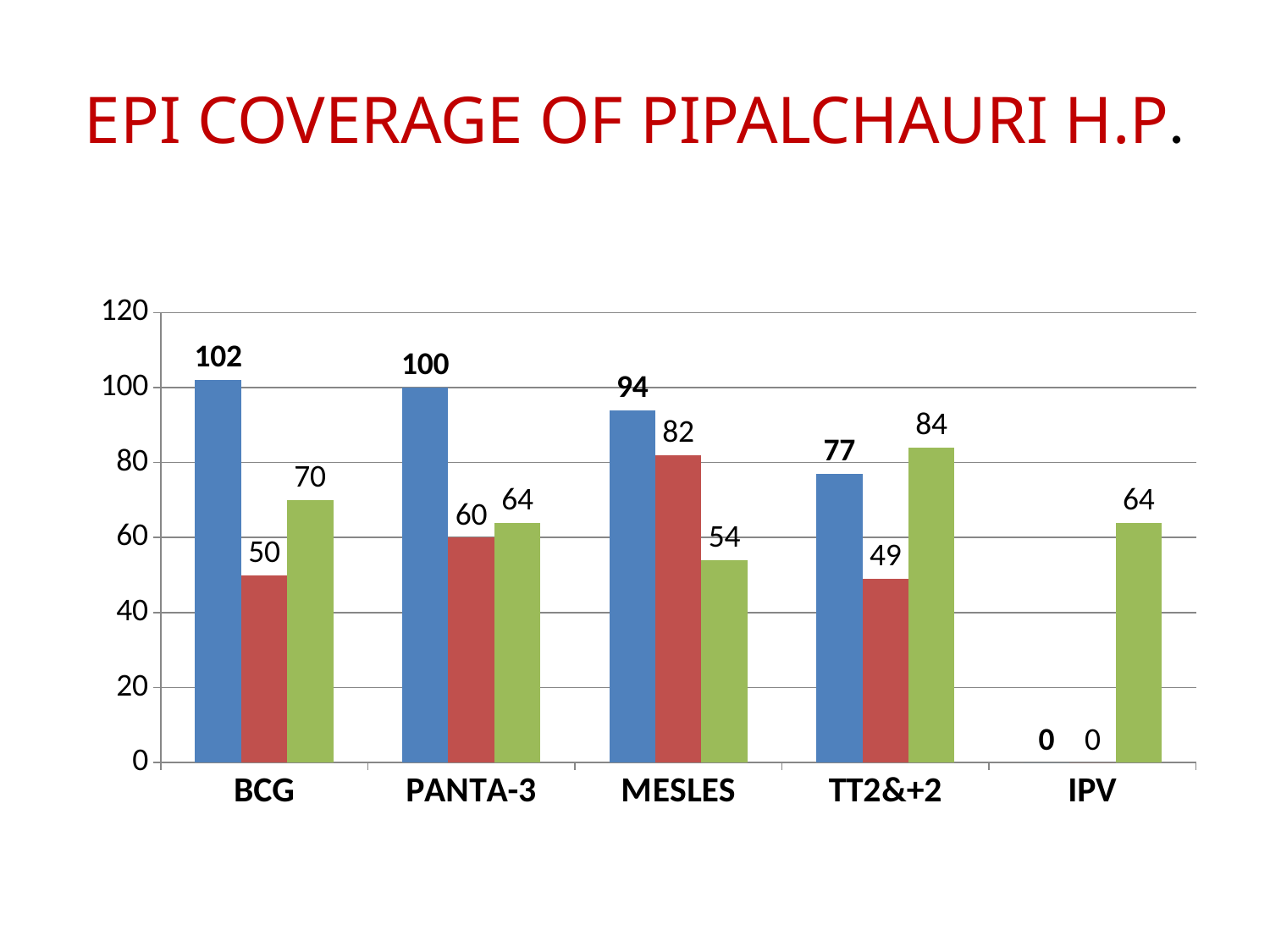
Which category has the lowest red bar? IPV What is the value of the red bar for MESLES? 82 What kind of chart is shown on the slide? bar chart What is the value of the blue bar for BCG? 102 What is the value of the green bar for IPV? 64 Do the blue bars rise or fall from BCG to IPV? fall What is the title of the slide? EPI COVERAGE OF PIPALCHAURI H.P. What is the difference between the blue bar and the red bar for BCG? 52 Which category has the highest blue bar? BCG Which is larger for PANTA-3, the red bar or the green bar? the green bar How many categories are shown on the x axis? 5 What is the value of the green bar for TT2&+2? 84